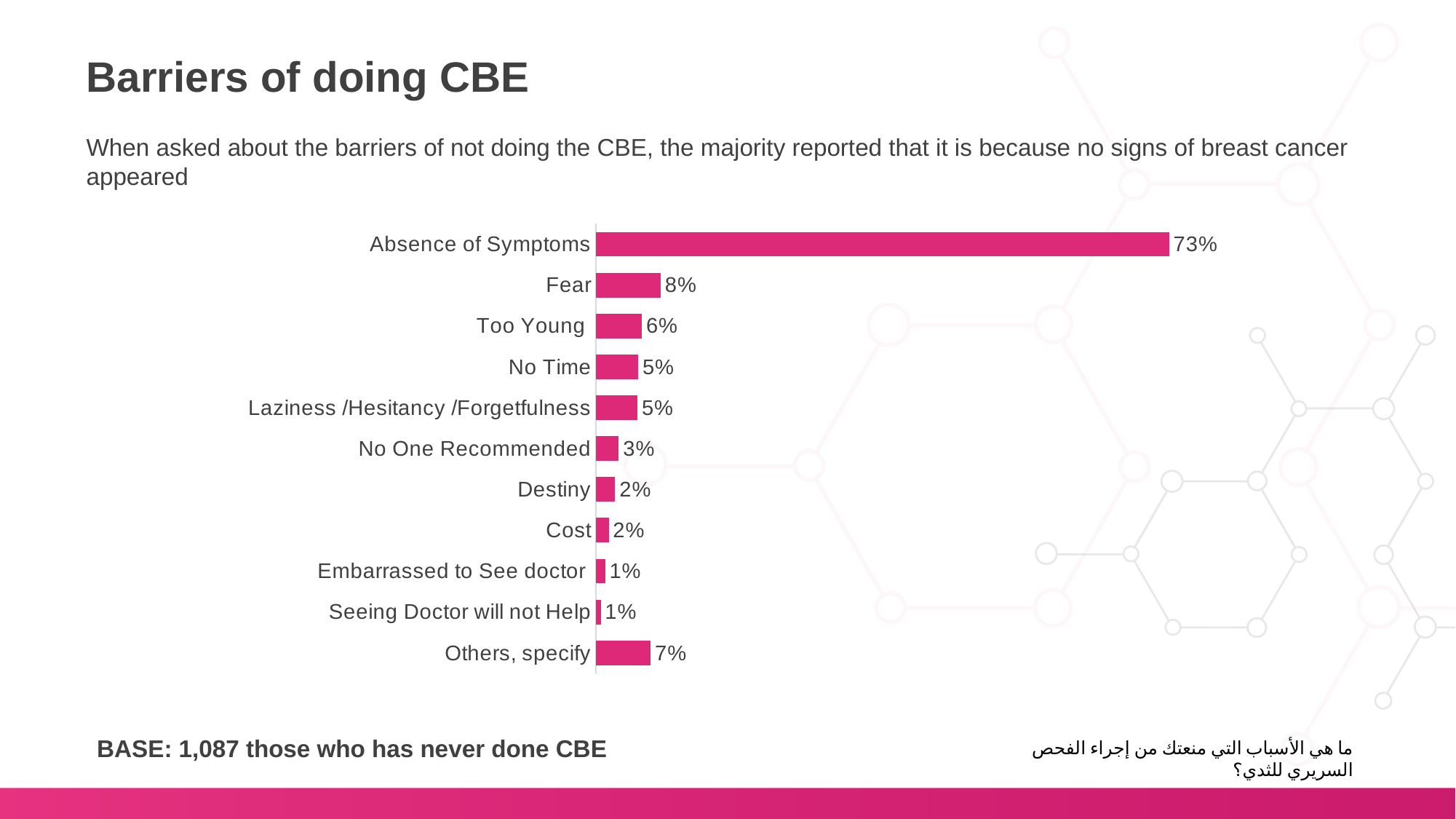
What is the value shown for Fear? 8% Which is larger, the value for Others, specify or the value for No Time? Others, specify What percentage of respondents cited Absence of Symptoms as a barrier to doing CBE? 73% What is the value for No One Recommended? 3% What is the difference between the values for Too Young and Destiny? 4% What is the difference between the values for Absence of Symptoms and Fear? 65% Which barrier has the highest percentage? Absence of Symptoms How many barrier categories are shown in the chart? 11 What percentage is shown for Others, specify? 7% What kind of chart is shown on the slide? Bar chart Which is larger, the value for Fear or the value for Too Young? Fear What is the base size stated below the chart? 1,087 those who has never done CBE